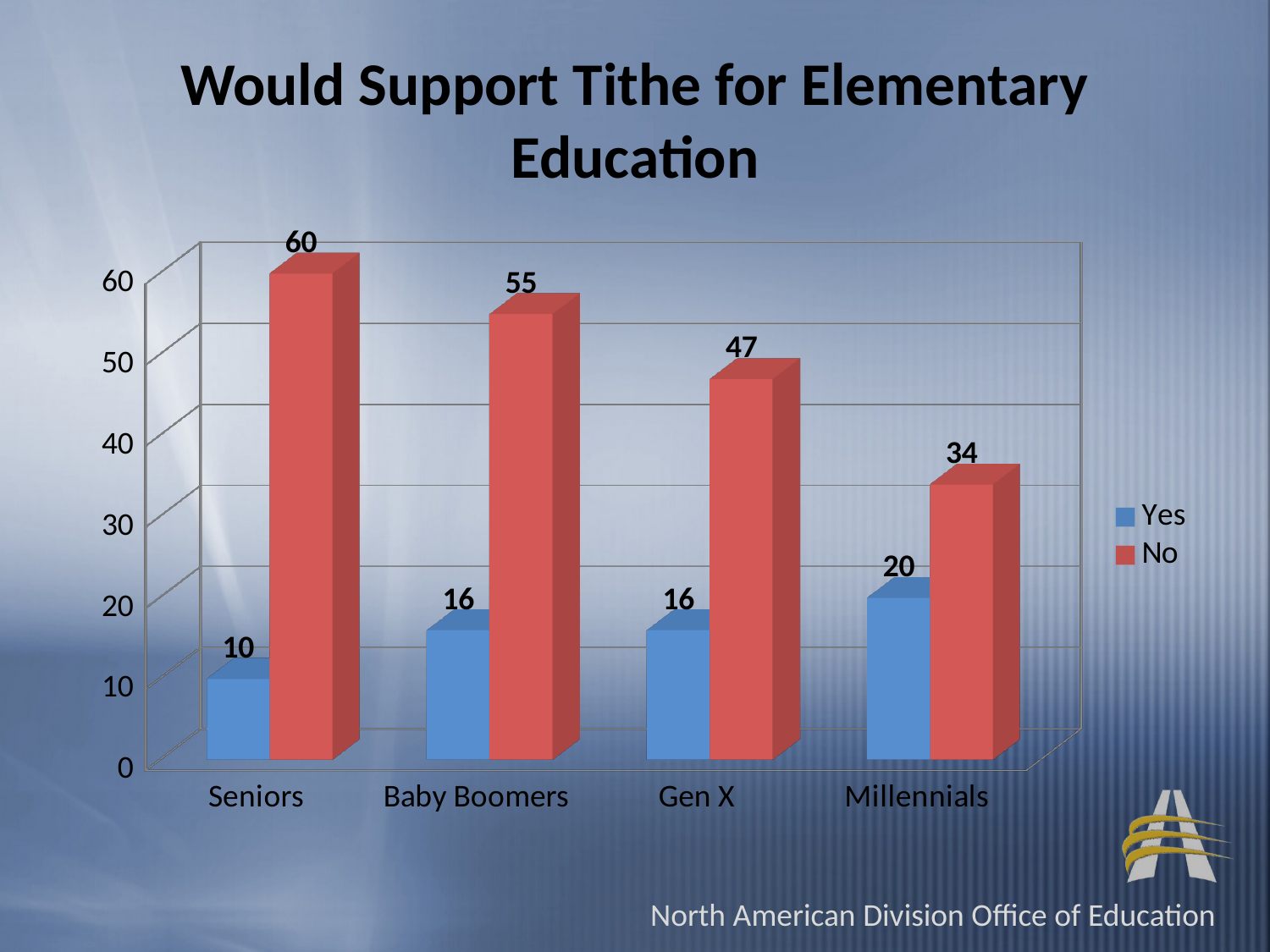
What kind of chart is shown on the slide? bar chart Which is larger, the Yes value for Millennials or the Yes value for Baby Boomers? Millennials Which category has the lowest Yes value? Seniors How many categories are shown on the x axis? 4 What is the value for No for Millennials? 34 Which category has the highest No value? Seniors What is the difference between the No and Yes values for Gen X? 31 How many series does the legend list? 2 What is the value for No for Baby Boomers? 55 What is the title of the chart? Would Support Tithe for Elementary Education Is the No value for Gen X greater or less than 40? greater What is the value for Yes for Seniors? 10